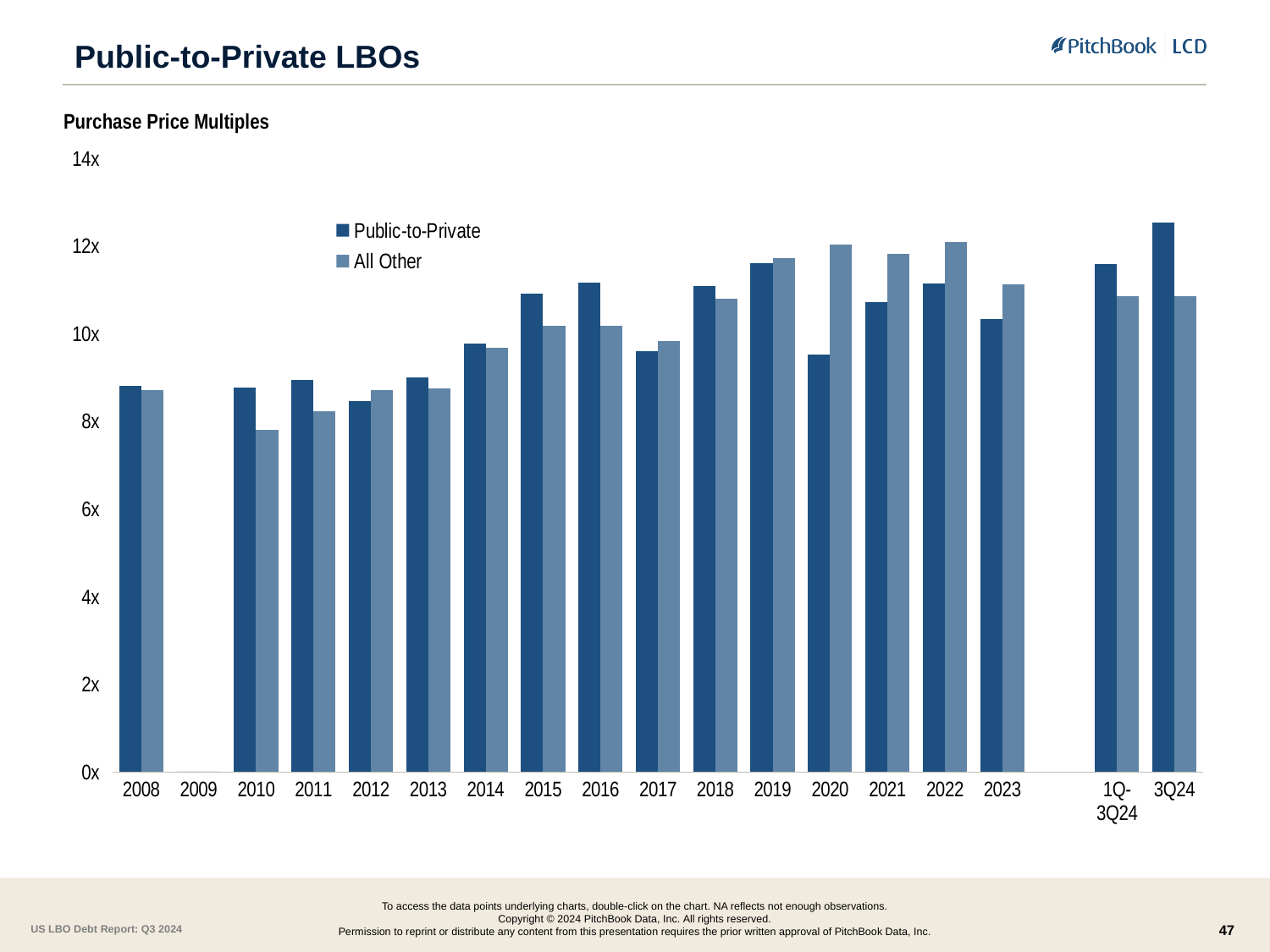
What kind of chart is shown on the slide? bar chart In 2020, which series has the larger value, Public-to-Private or All Other? All Other Is the Public-to-Private value for 3Q24 greater or less than 12x? greater Is the All Other value for 2010 greater or less than 8x? less Which category has the lowest All Other value? 2010 What are the two series named in the legend? Public-to-Private and All Other How many series does the legend list? 2 Is the Public-to-Private value for 2020 greater or less than 10x? less Which category has the highest Public-to-Private value? 3Q24 In 2016, which series has the larger value, Public-to-Private or All Other? Public-to-Private Which year on the x axis has no bars plotted? 2009 How many categories are labelled on the x axis? 18